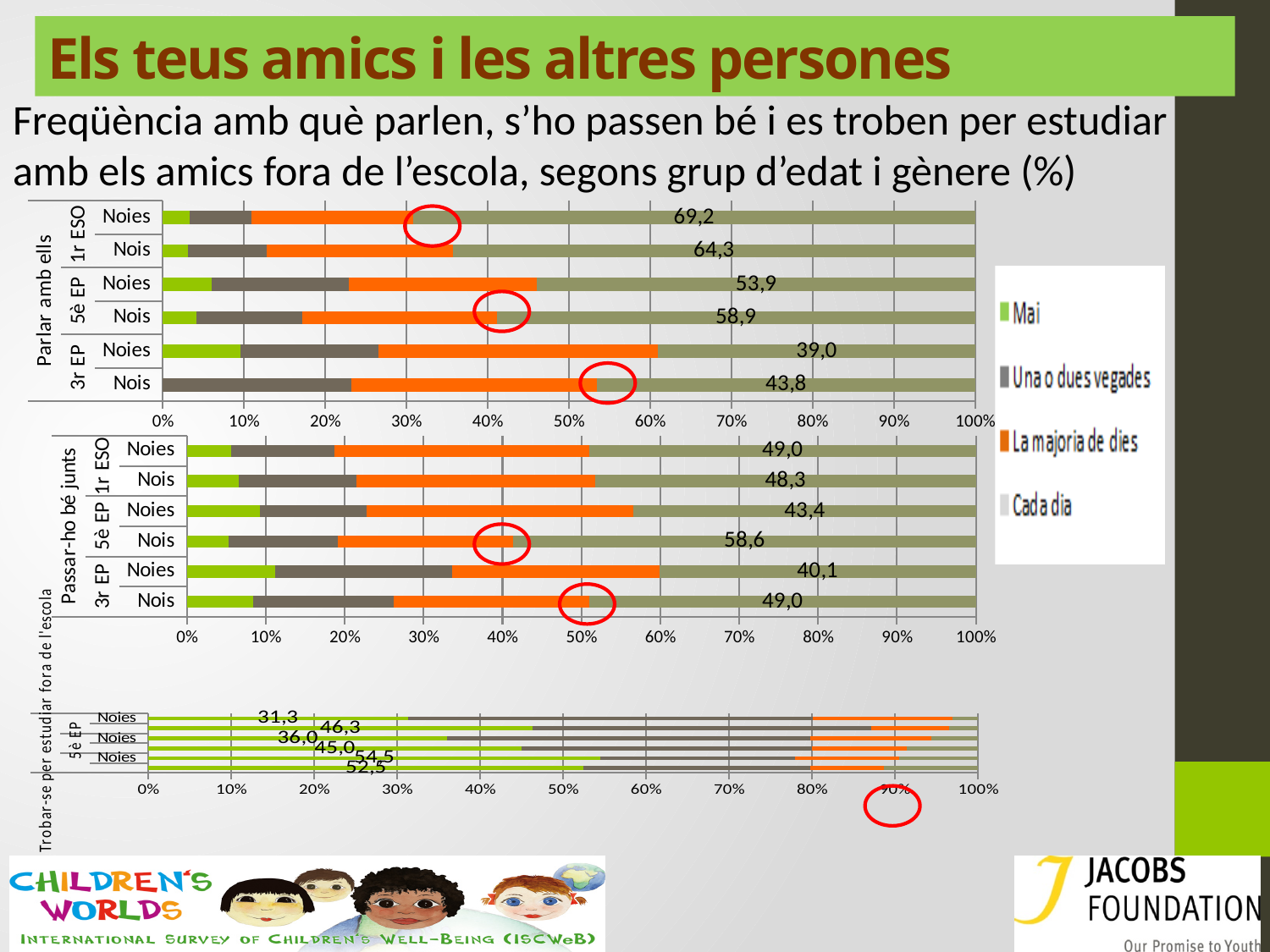
In the 'Parlar amb ells' chart, what is the 'Cada dia' value for 1r ESO Noies? 69,2 What kind of chart is the 'Parlar amb ells' chart? Stacked bar chart In the 'Passar-ho bé junts' chart, what is the 'Cada dia' value for 5è EP Nois? 58,6 In the 'Parlar amb ells' chart, what is the difference between the 'Cada dia' values for 1r ESO Noies and 1r ESO Nois? 4,9 In the 'Passar-ho bé junts' chart, which group has the lowest 'Cada dia' value? 3r EP Noies In the 'Passar-ho bé junts' chart, which has the larger 'Cada dia' value, 5è EP Noies or 5è EP Nois? 5è EP Nois How many bars are there in the 'Parlar amb ells' chart? 6 How many series does the legend list? 4 In the 'Parlar amb ells' chart, which group has the lowest 'Cada dia' value? 3r EP Noies Which legend entry is shown in orange? La majoria de dies In the 'Passar-ho bé junts' chart, what is the difference between the 'Cada dia' values for 5è EP Nois and 5è EP Noies? 15,2 In the 'Parlar amb ells' chart, which group has the highest 'Cada dia' value? 1r ESO Noies